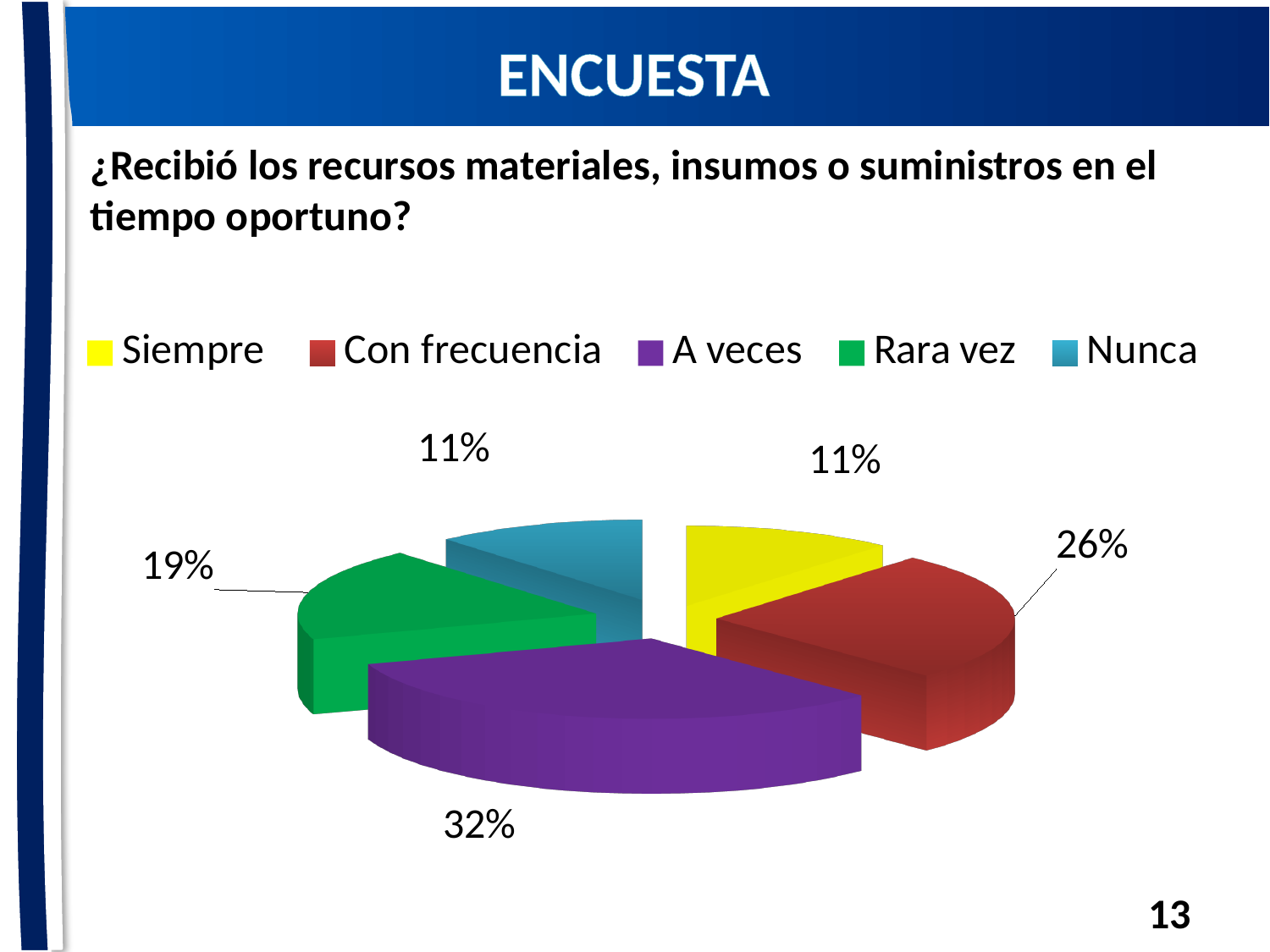
What share of the pie does "Nunca" represent? 11% What colour is the slice for "A veces"? purple What share of the pie does "A veces" represent? 32% What is the difference in percentage points between "A veces" and "Con frecuencia"? 6 What kind of chart is shown on the slide? pie chart Which is larger, the share for "Rara vez" or the share for "Nunca"? Rara vez What question does the chart on the slide answer? ¿Recibió los recursos materiales, insumos o suministros en el tiempo oportuno? What share of the pie does "Con frecuencia" represent? 26% How many categories does the legend list? 5 Which category has the largest slice of the pie? A veces